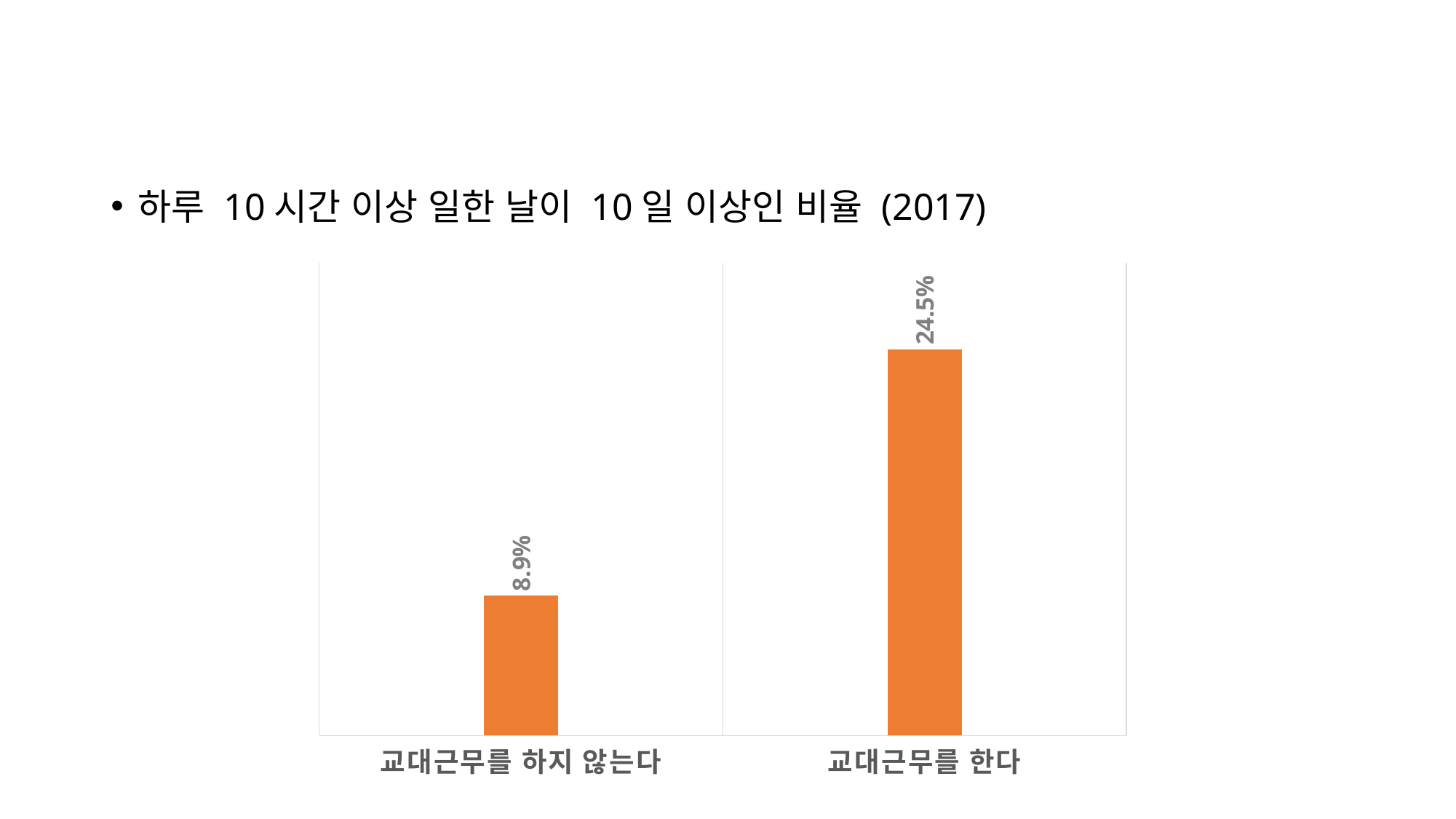
Which category has the lowest value? 교대근무를 하지 않는다 What year is referenced in the slide text above the chart? 2017 What is the value for 교대근무를 한다? 24.5% Which is larger, the value for 교대근무를 한다 or the value for 교대근무를 하지 않는다? 교대근무를 한다 What colour are the bars in the chart? orange Do the values rise or fall from left to right along the x axis? rise What is the value for 교대근무를 하지 않는다? 8.9% How many categories are shown in the chart? 2 Which category has the highest value? 교대근무를 한다 What is the difference between the values for 교대근무를 한다 and 교대근무를 하지 않는다? 15.6% What kind of chart is shown on the slide? bar chart